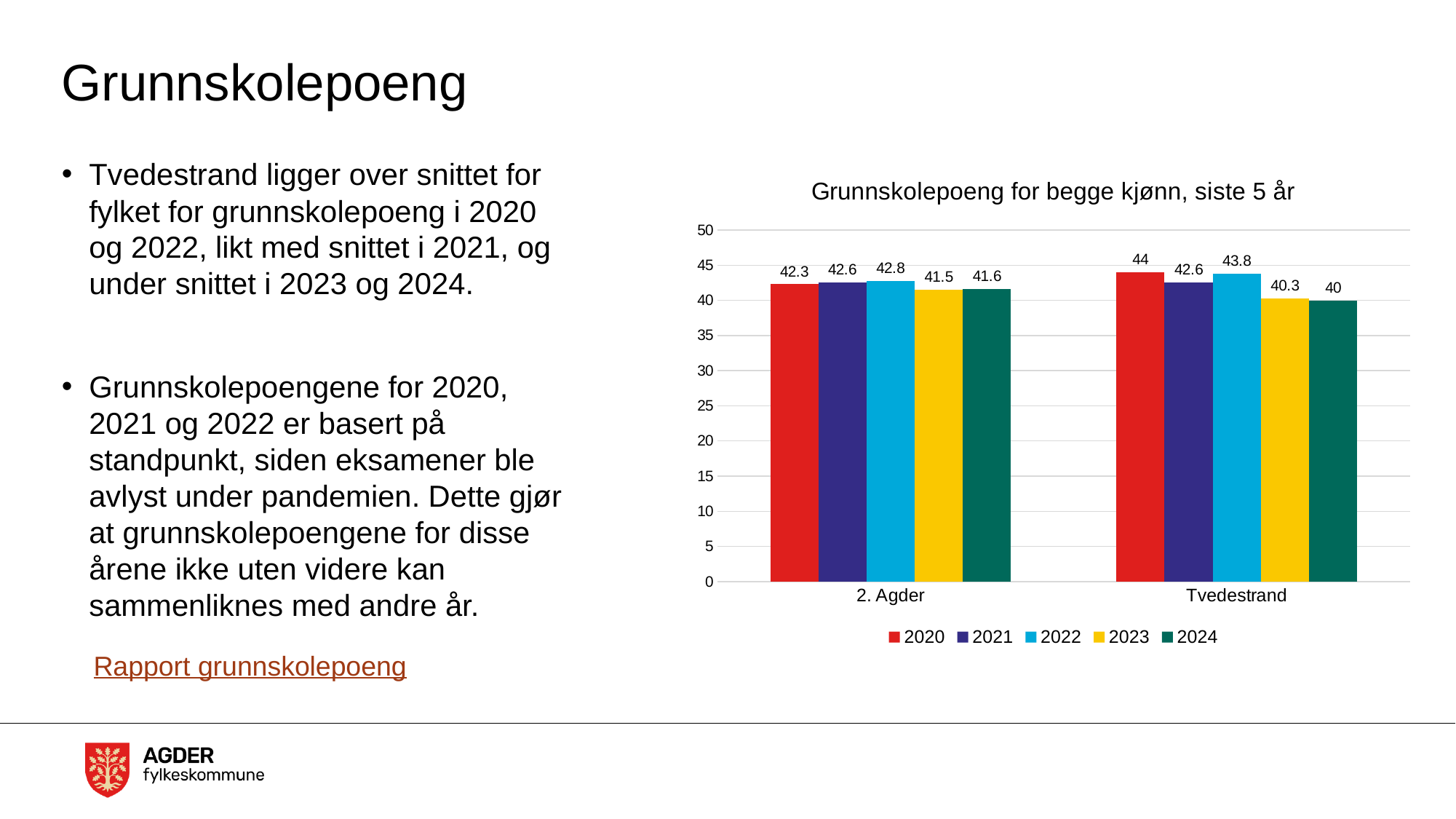
What is the title of the chart? Grunnskolepoeng for begge kjønn, siste 5 år What kind of chart is shown? Bar chart How many categories are shown on the x axis? 2 How many series does the legend list? 5 Which year has the lowest value for Tvedestrand? 2024 Which is larger, the 2023 value for 2. Agder or for Tvedestrand? 2. Agder What is the difference between the 2020 values for Tvedestrand and 2. Agder? 1.7 What is the value for Tvedestrand in 2022? 43.8 What is the value for 2. Agder in 2023? 41.5 What is the value for 2. Agder in 2020? 42.3 Which year has the highest value for Tvedestrand? 2020 What is the value for Tvedestrand in 2024? 40